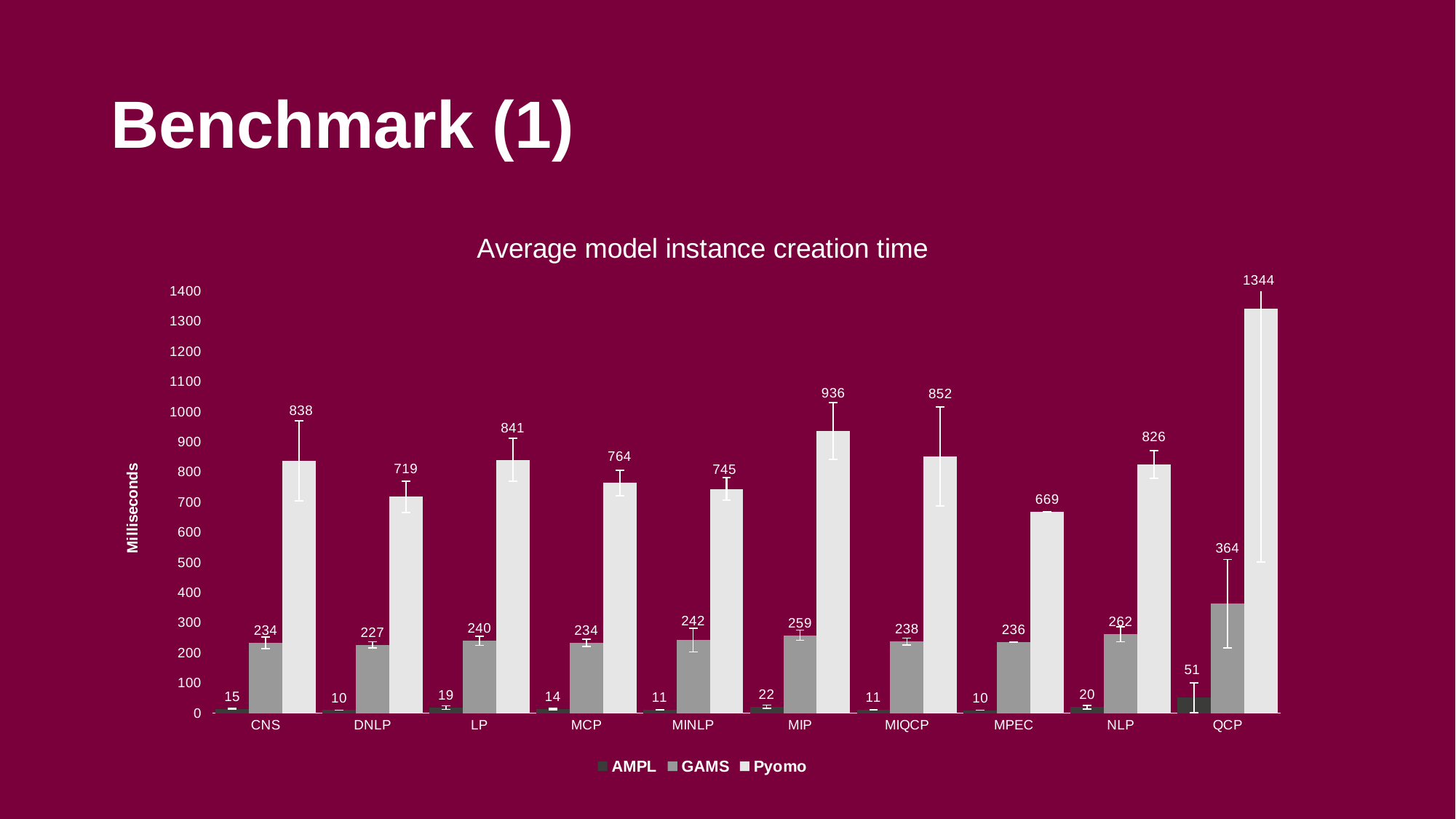
How many categories are shown on the x axis? 10 What is the difference between the Pyomo and GAMS values for CNS? 604 What is the AMPL value for QCP? 51 Which category has the highest Pyomo value? QCP Is the Pyomo value for MIQCP greater or less than 800? greater How many series does the legend list? 3 What is the GAMS value for NLP? 262 What is the title of the chart? Average model instance creation time What kind of chart is shown on the slide? bar chart Which category has the lowest Pyomo value? MPEC Which is larger, the Pyomo value for DNLP or the Pyomo value for MINLP? MINLP What is the Pyomo value for MIP? 936